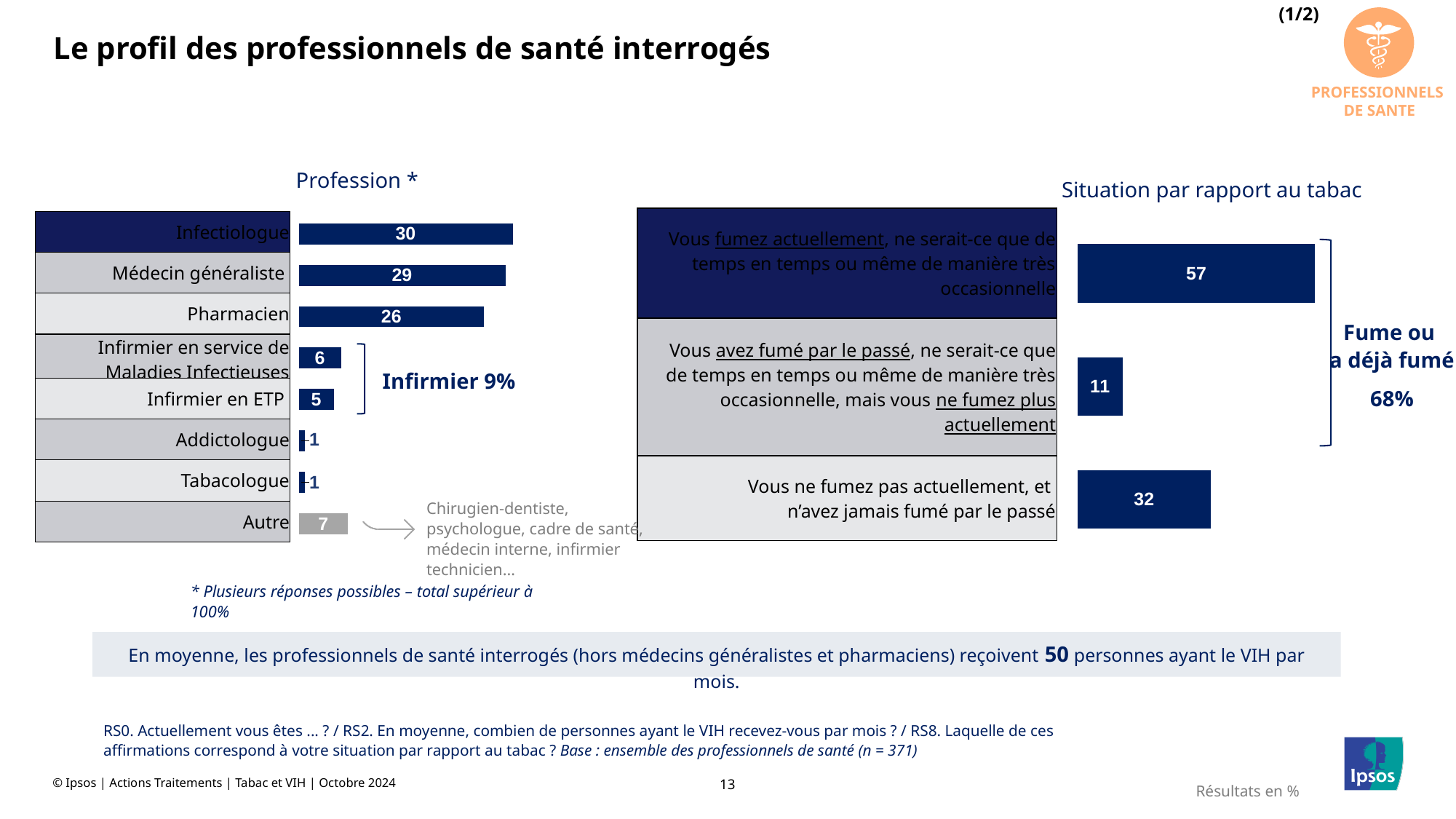
What percentage is shown next to the bracket labelled 'Fume ou a déjà fumé' in the 'Situation par rapport au tabac' chart? 68% In the 'Profession *' chart, what is the value for Pharmacien? 26 In the 'Situation par rapport au tabac' chart, what is the value for those who have never smoked ('Vous ne fumez pas actuellement, et n'avez jamais fumé par le passé')? 32 In the 'Profession *' chart, which profession has the highest value? Infectiologue How many profession categories are shown in the 'Profession *' chart? 8 In the 'Profession *' chart, what is the difference between Médecin généraliste and Infirmier en ETP? 24 In the 'Profession *' chart, which is larger: Pharmacien or Autre? Pharmacien In the 'Profession *' chart, what is the value for Infectiologue? 30 In the 'Situation par rapport au tabac' chart, what is the value for those who currently smoke ('Vous fumez actuellement')? 57 In the 'Situation par rapport au tabac' chart, which category has the lowest value? Vous avez fumé par le passé, mais vous ne fumez plus actuellement In the 'Situation par rapport au tabac' chart, what is the difference between the current smokers (57) and the former smokers (11)? 46 What kind of chart is the 'Profession *' chart? Bar chart